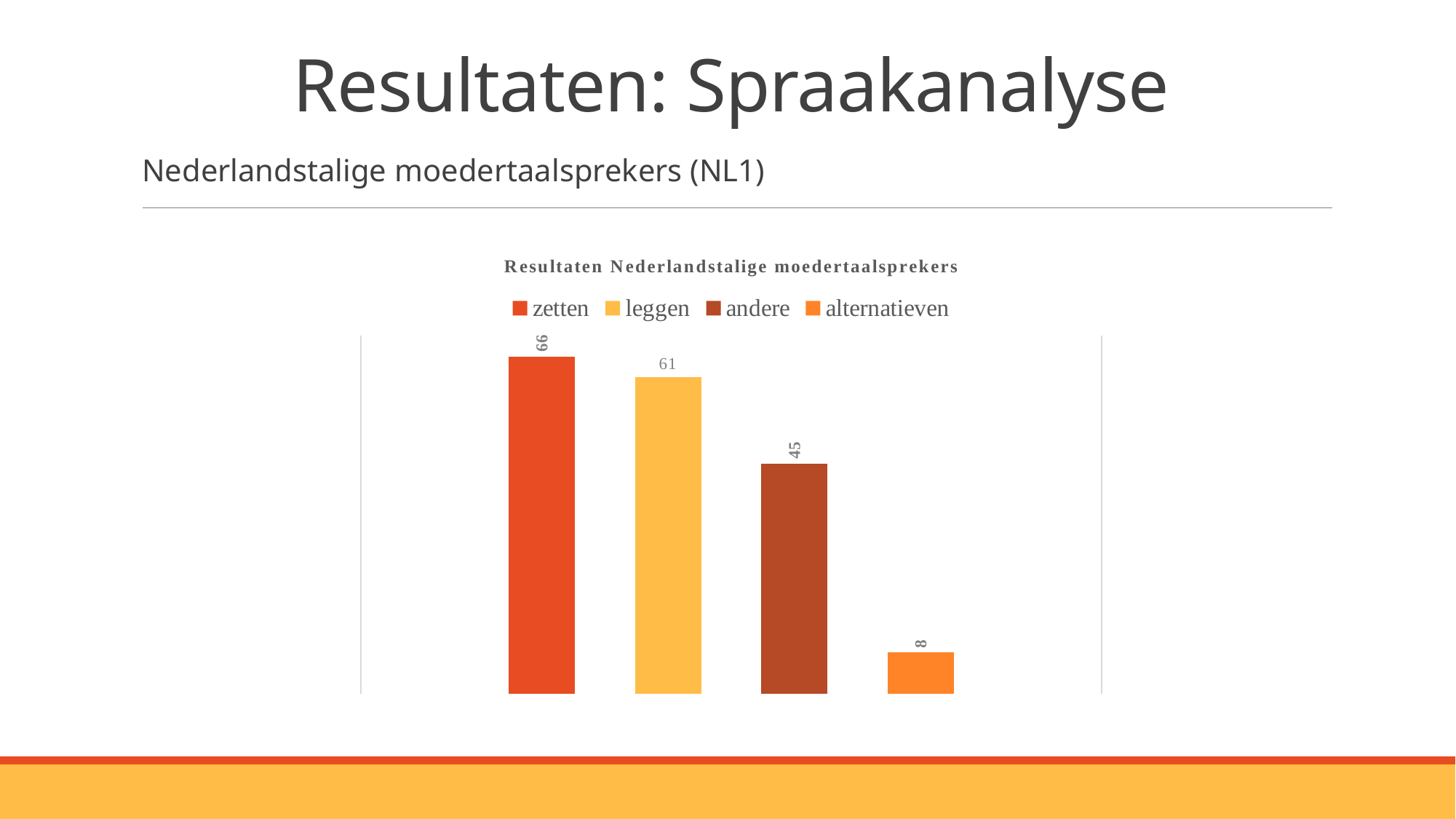
Which is larger, the value for leggen or the value for andere? leggen What is the difference between the values for andere and alternatieven? 37 How many bars are shown in the chart? 4 How many entries does the legend list? 4 What is the difference between the values for zetten and leggen? 5 What is the value for leggen? 61 What kind of chart is shown on the slide? bar chart What is the value for andere? 45 What is the value for alternatieven? 8 What is the value for zetten? 66 Which category has the lowest value? alternatieven Which category has the highest value? zetten